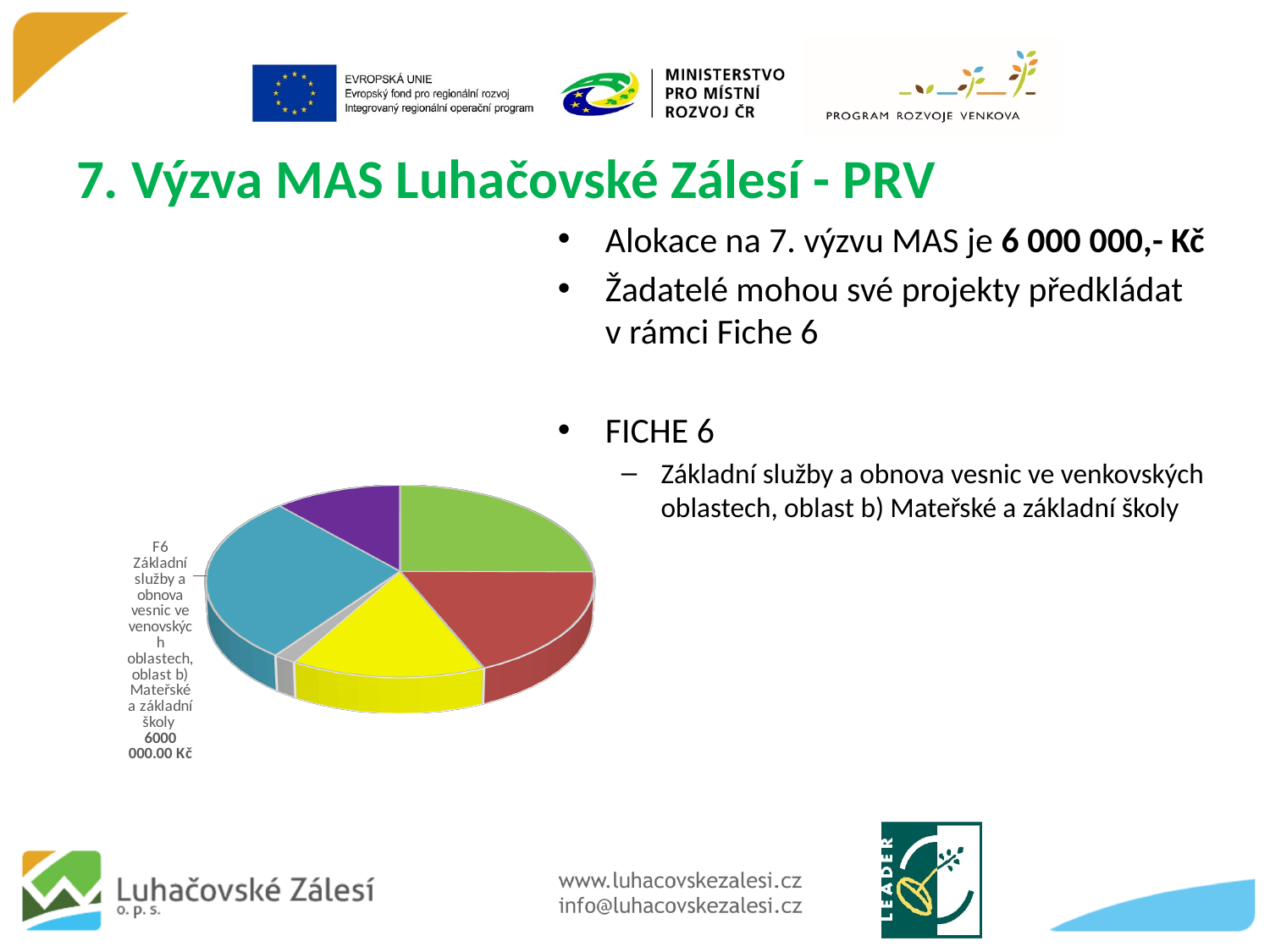
What colour is the slice labelled F6 in the pie chart? blue Which colour slice is the smallest in the pie chart? grey What value is shown for the slice labelled F6 Základní služby a obnova vesnic ve venovských oblastech, oblast b) Mateřské a základní školy? 6000 000.00 Kč How many slices does the pie chart have? 6 What kind of chart is shown on the slide? pie chart